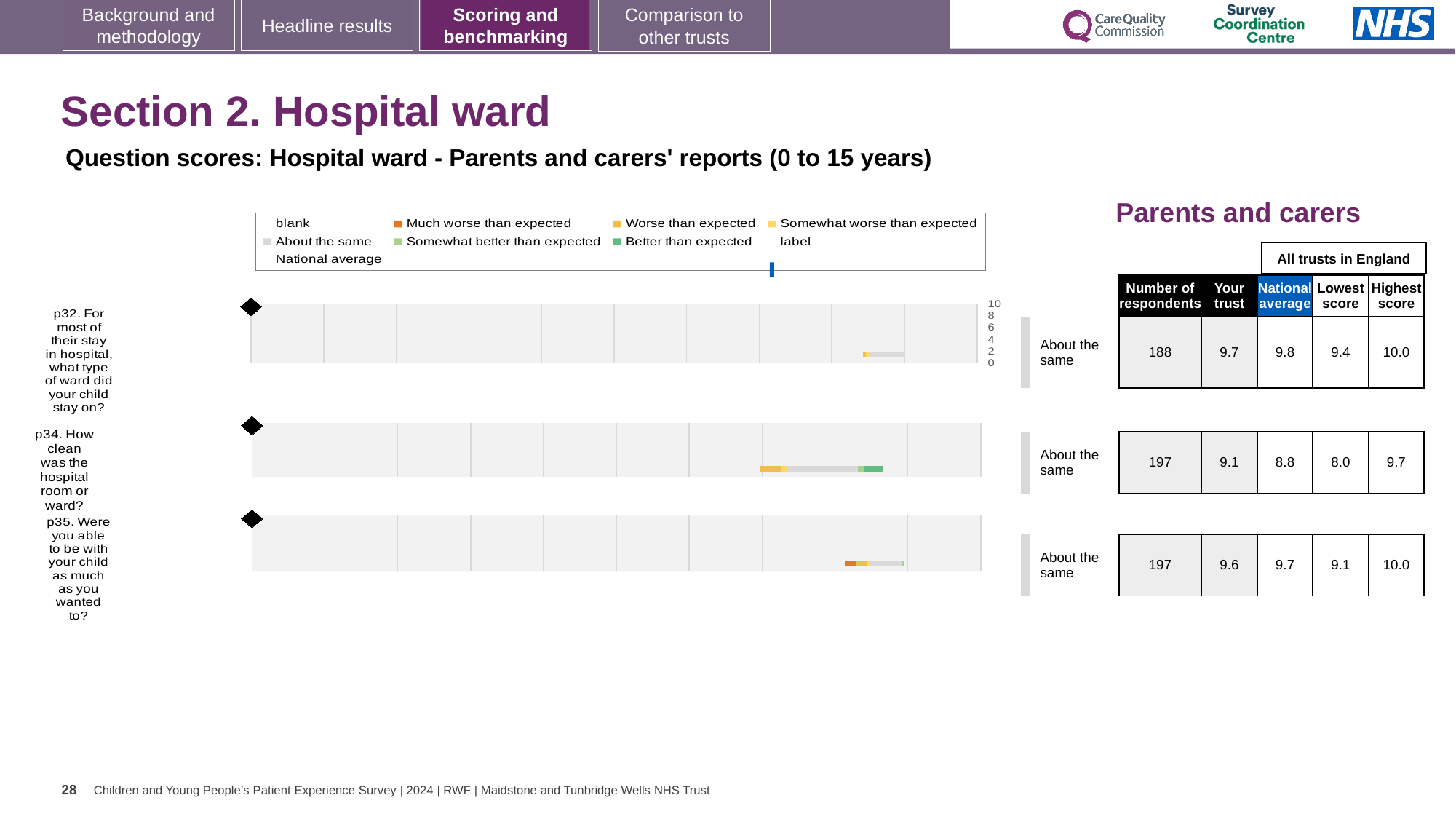
What is the highest score among all trusts in England for p34? 9.7 For p34, how much higher is the 'Your trust' score than the national average? 0.3 Which question has the highest 'Your trust' score? p32 Which question has the lowest 'Your trust' score? p34 What is the lowest score among all trusts in England for p35? 9.1 What is the 'Your trust' score for p34 (How clean was the hospital room or ward?)? 9.1 For p35, which is larger: the 'Your trust' score or the national average? National average How many survey questions (p32, p34, p35) are plotted on the slide? 3 What kind of chart is used to show the question scores on this slide? bar chart What is the national average score for p32 (what type of ward did your child stay on)? 9.8 How many respondents answered p35 (Were you able to be with your child as much as you wanted to?)? 197 What benchmark category is shown next to the chart for p32? About the same